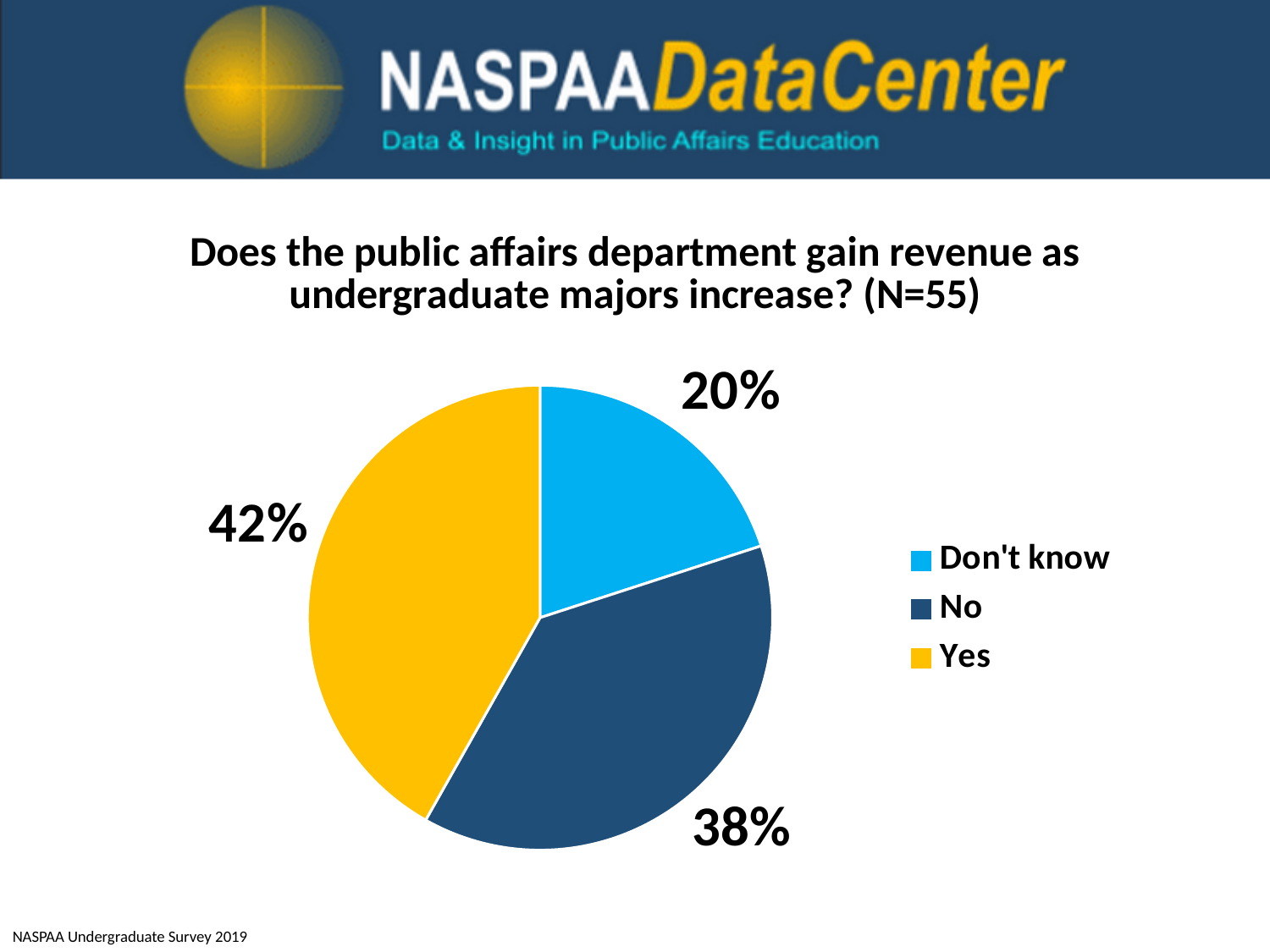
How many slices does the pie chart have? 3 Which is larger, the "No" slice or the "Don't know" slice? No What kind of chart is shown on the slide? pie chart What percentage of respondents answered "Don't know"? 20% How many entries does the legend list? 3 What is the difference in percentage points between the "No" and "Don't know" slices? 18 What percentage of respondents answered "Yes"? 42% What colour is the "Yes" slice? yellow Which response has the smallest share of the pie? Don't know What is the difference in percentage points between the "Yes" and "No" slices? 4 What percentage of respondents answered "No"? 38% Which response has the largest share of the pie? Yes